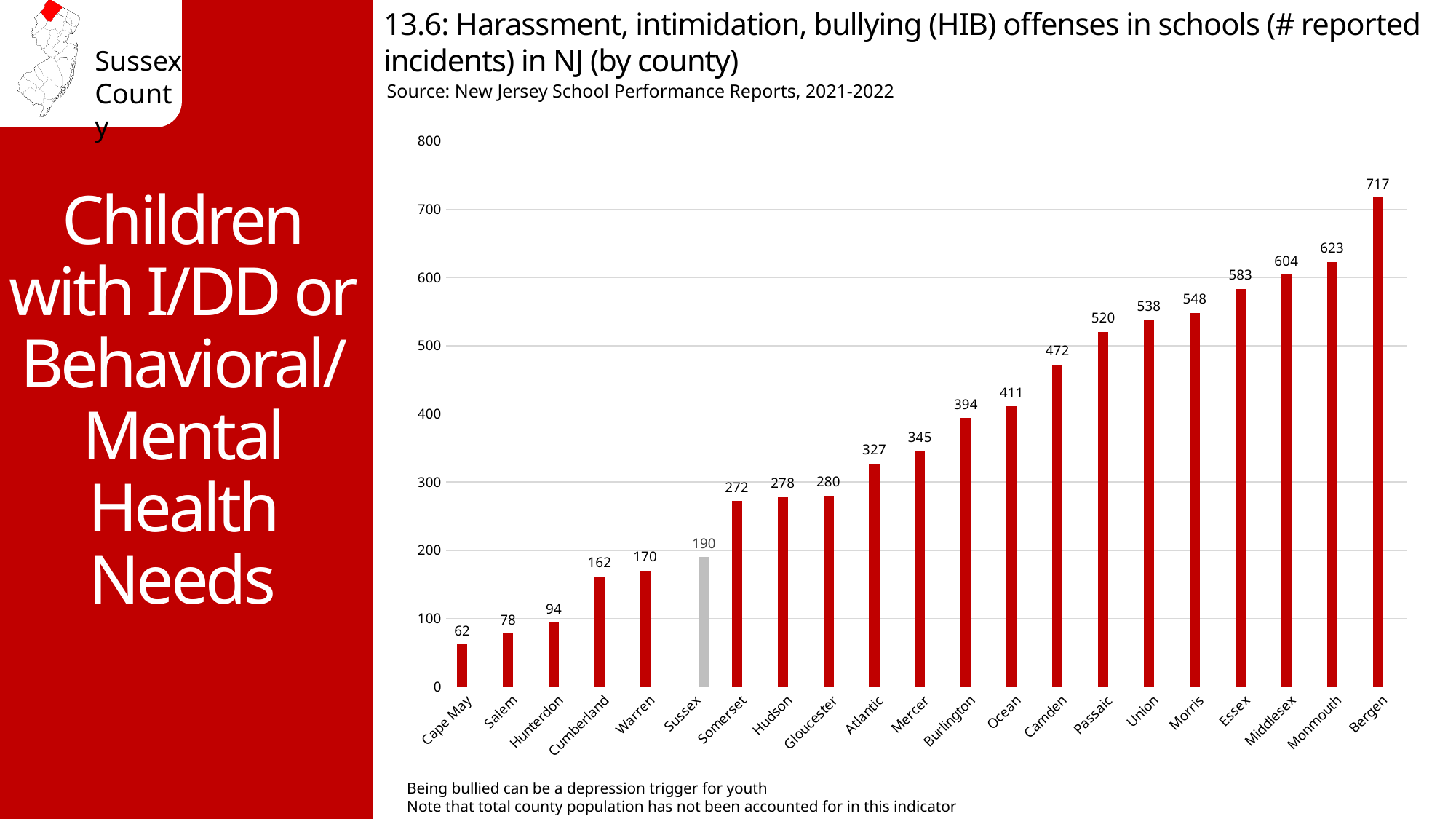
Which county has more reported HIB incidents, Camden or Ocean? Camden Which county has the lowest number of reported HIB incidents? Cape May What is the number of reported HIB incidents for Bergen? 717 What is the number of reported HIB incidents for Sussex? 190 What kind of chart is shown on the slide? Bar chart Which county's bar is shown in grey rather than red? Sussex What is the difference in reported HIB incidents between Bergen and Cape May? 655 Is the value for Passaic greater or less than 500? greater What is the difference in reported HIB incidents between Sussex and Warren? 20 How many counties are shown on the chart? 21 Which county has the highest number of reported HIB incidents? Bergen What is the number of reported HIB incidents for Mercer? 345